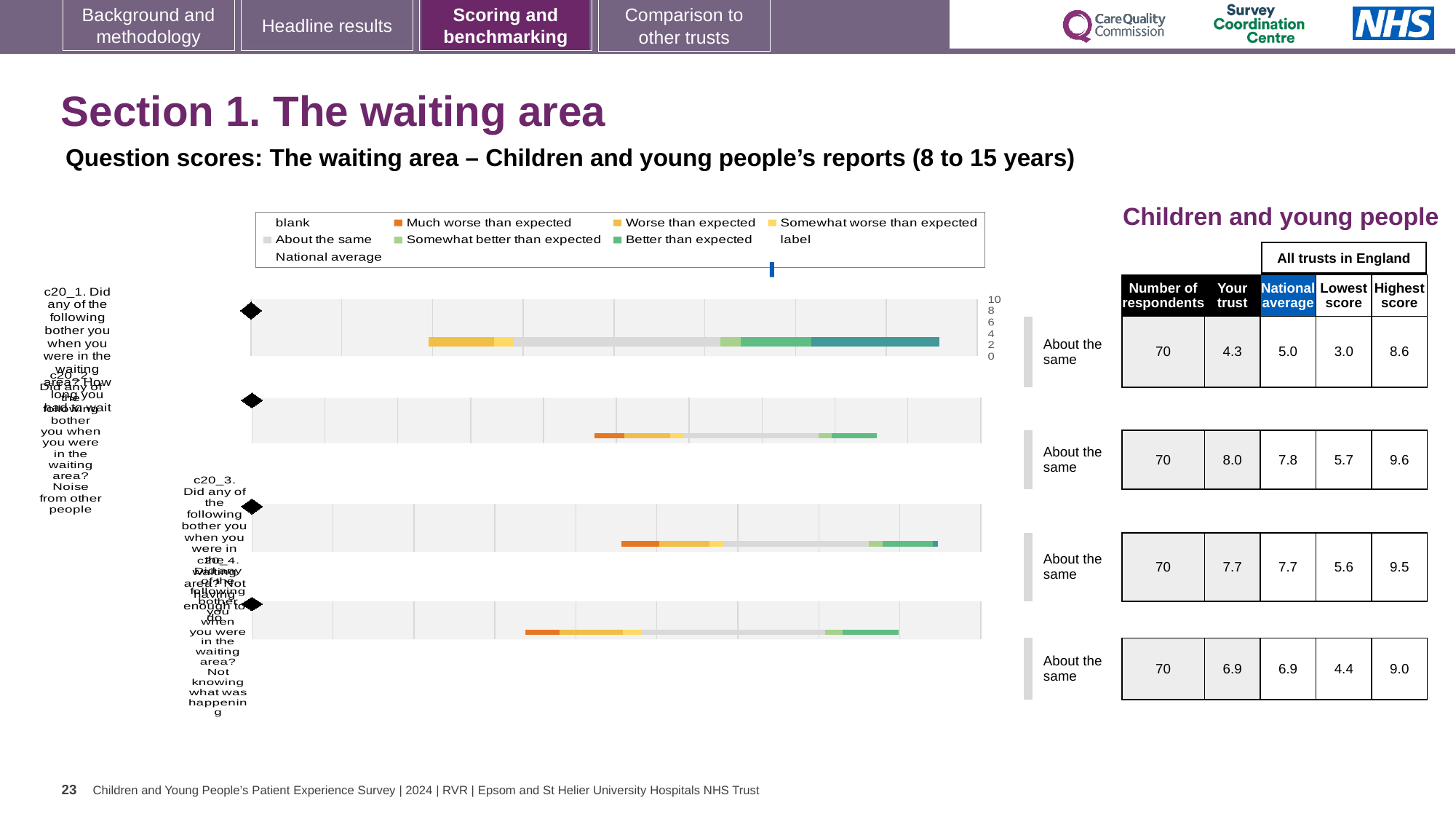
What is the national average score for question c20_2 (how long you had to wait)? 7.8 Which question has the lowest 'Your trust' score? c20_1 (noise from other people) What is the highest value shown on the score axis of the bar charts? 10 How many question rows (bar charts) are shown for the waiting area section? 4 Which question has the highest 'Your trust' score? c20_2 (how long you had to wait) What is the 'Your trust' score for question c20_1 (noise from other people)? 4.3 What is the lowest score among all trusts in England for question c20_4 (not knowing what was happening)? 4.4 What kind of chart is used to show the question scores for the waiting area? bar chart What colour does the legend use for 'Much worse than expected'? orange What is the difference between the 'Your trust' score and the national average for question c20_1? 0.7 How many respondents answered each of the waiting area questions? 70 What is the highest score among all trusts in England for question c20_3 (not having enough to do)? 9.5